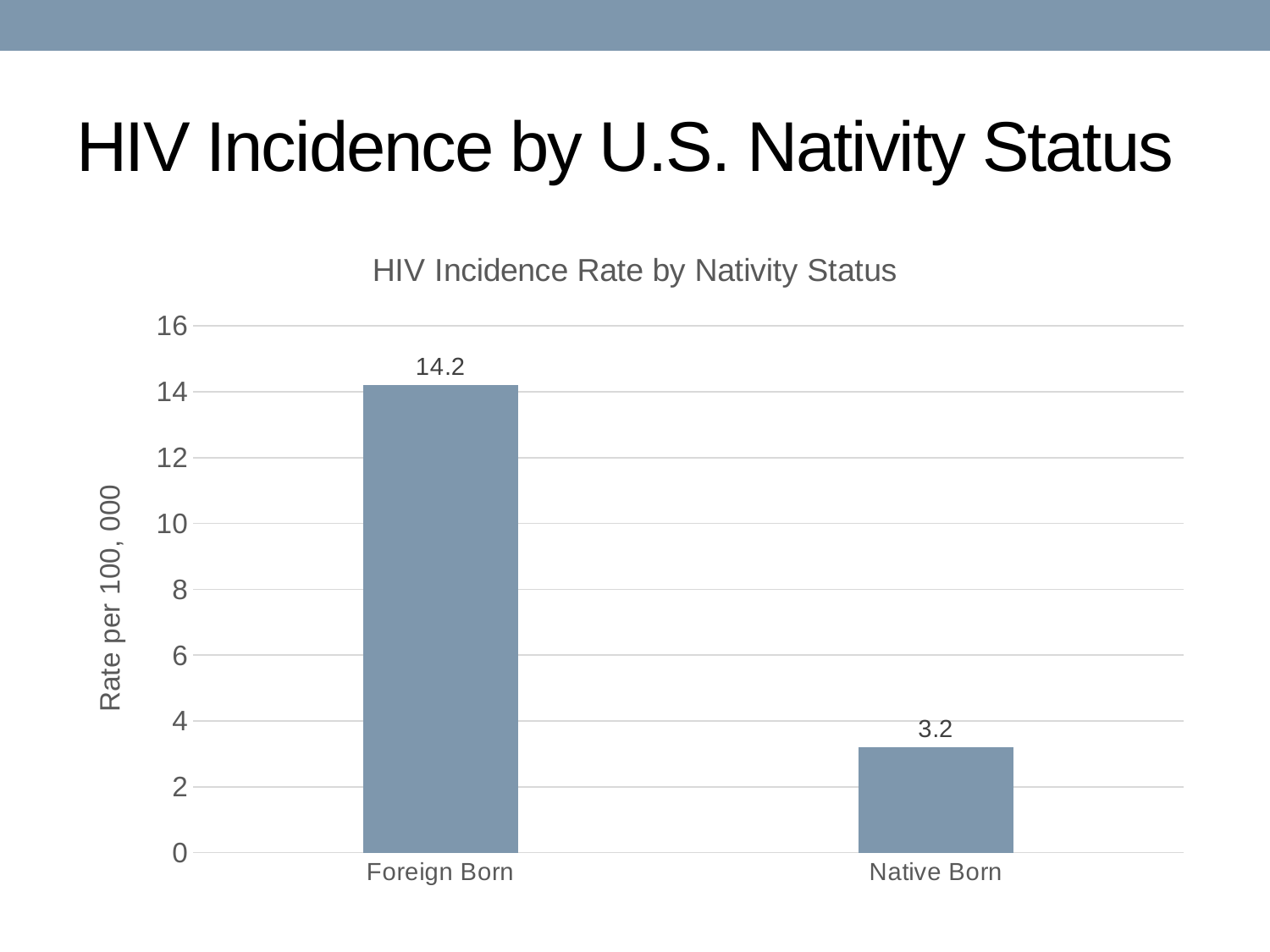
Is the value for Foreign Born greater or less than 10? greater What is the title of the chart? HIV Incidence Rate by Nativity Status Is the HIV incidence rate higher for Foreign Born or Native Born? Foreign Born How many categories are shown on the chart? 2 Which nativity status has the higher HIV incidence rate? Foreign Born What is the difference between the Foreign Born and Native Born HIV incidence rates? 11.0 What is the HIV incidence rate for Native Born? 3.2 Is the value for Native Born greater or less than 4? less Which nativity status has the lower HIV incidence rate? Native Born What kind of chart is shown on the slide? bar chart What is the label of the vertical axis? Rate per 100, 000 What is the HIV incidence rate for Foreign Born? 14.2